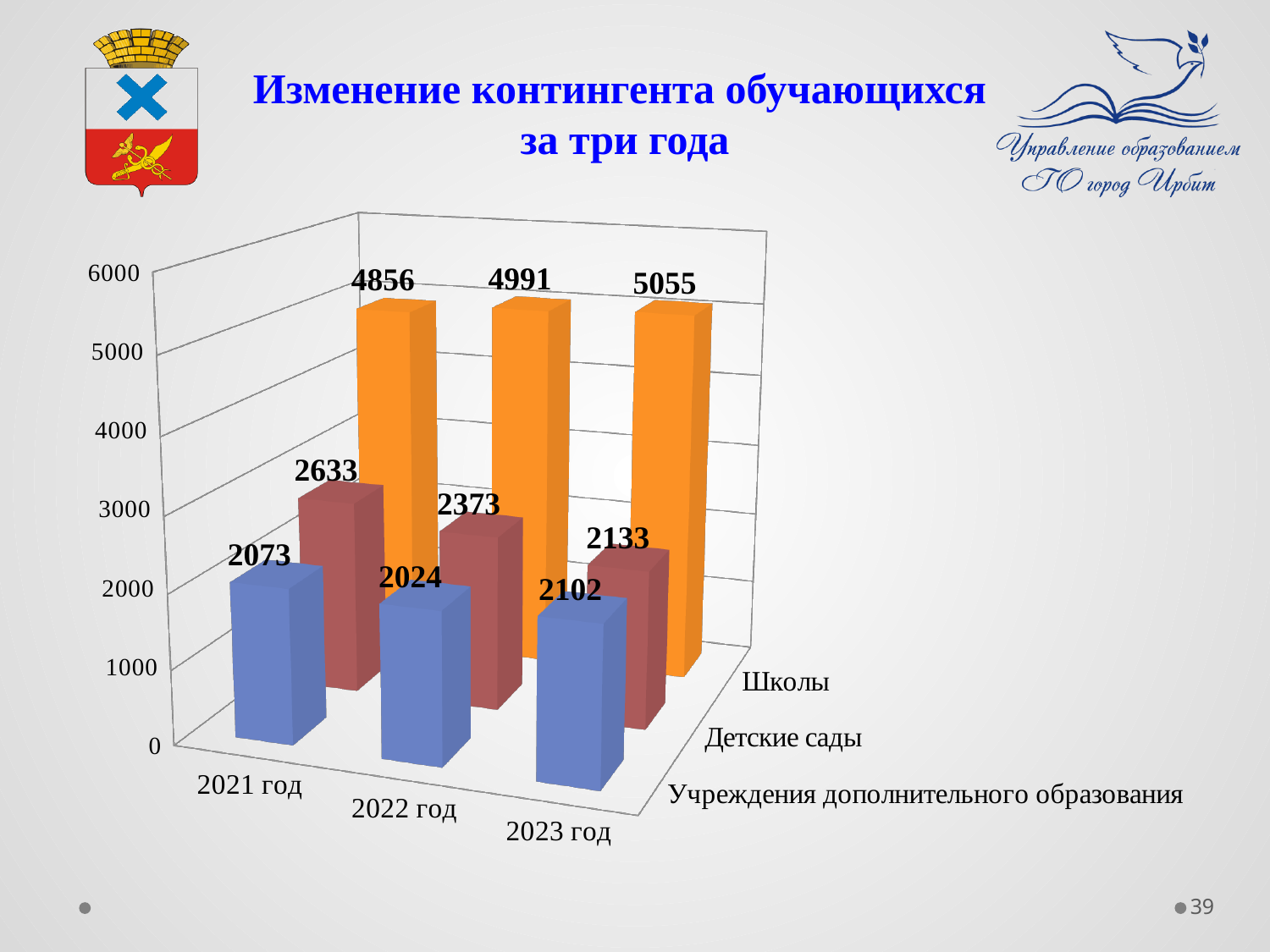
What is the value for Школы in 2023 год? 5055 What is the value for Детские сады in 2021 год? 2633 Which is larger in 2022 год: Детские сады or Учреждения дополнительного образования? Детские сады In which year is the value for Детские сады the lowest? 2023 год How many series are plotted on the chart? 3 Is the value for Школы in 2021 год greater or less than 4000? greater Do the values for Детские сады rise or fall from 2021 год to 2023 год? fall How many years are shown on the chart? 3 What is the value for Учреждения дополнительного образования in 2022 год? 2024 In which year is the value for Школы the highest? 2023 год What kind of chart is shown on the slide? bar chart What is the difference between the Школы values for 2023 год and 2021 год? 199